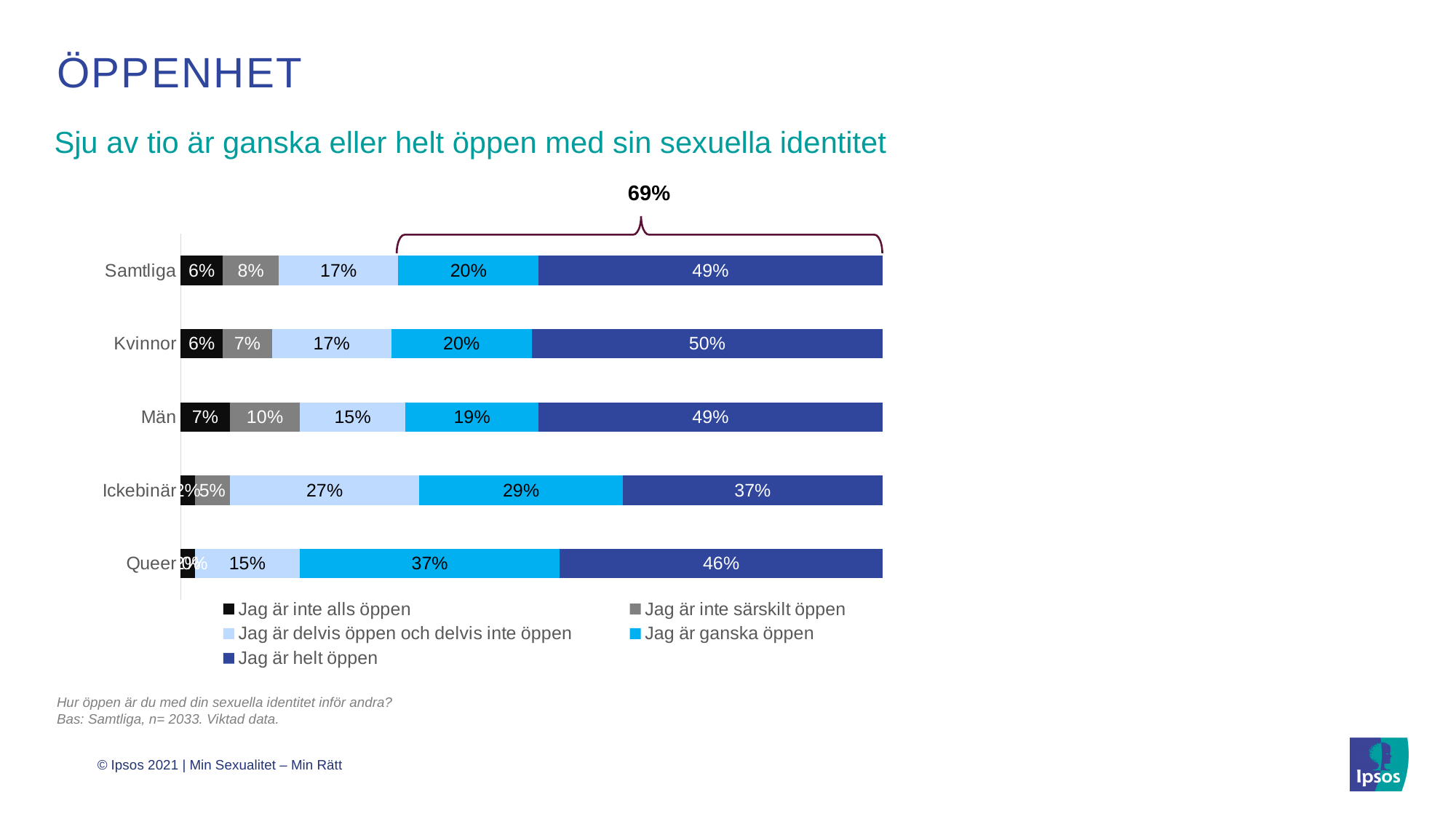
What percentage is shown above the bracket spanning the two rightmost segments of the Samtliga bar? 69% Which category has the highest value for "Jag är ganska öppen"? Queer Which category has the lowest value for "Jag är helt öppen"? Ickebinär What kind of chart is shown on the slide? stacked bar chart How many categories (groups) are plotted on the chart? 5 What is the value for "Jag är delvis öppen och delvis inte öppen" for Samtliga? 17% What is the value for "Jag är ganska öppen" for Ickebinär? 29% What is the value for "Jag är helt öppen" for Kvinnor? 50% What is the difference between the "Jag är helt öppen" values for Kvinnor and Ickebinär? 13% What is the value for "Jag är inte särskilt öppen" for Män? 10% How many series does the legend list? 5 Which is larger: the "Jag är ganska öppen" value for Män or for Ickebinär? Ickebinär